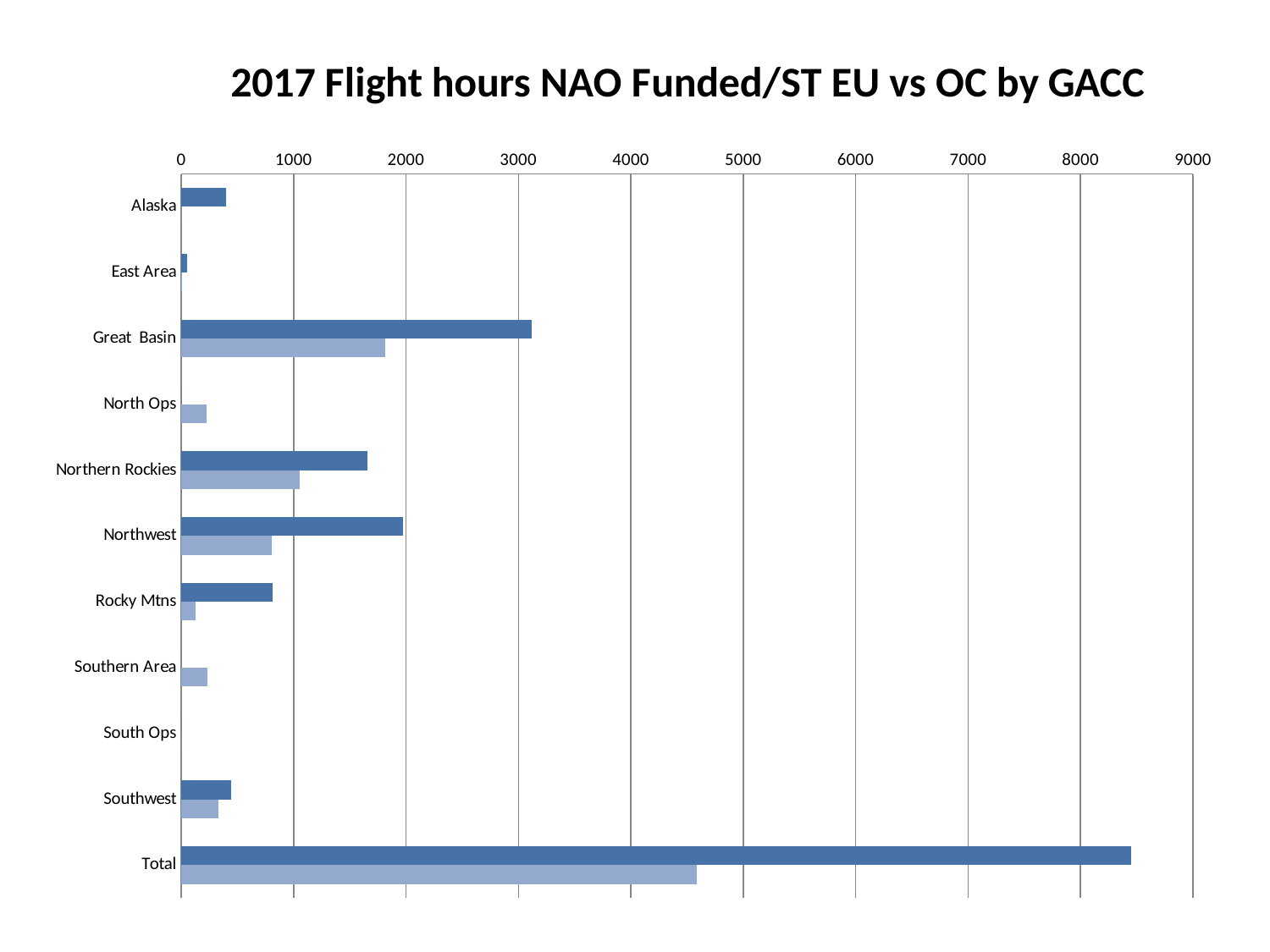
Which has the longer dark blue bar, Great Basin or Northwest? Great Basin Which category shows no visible bar for either series? South Ops Is the dark blue bar for Total greater or less than 8000? greater Is the dark blue bar for Great Basin greater or less than 2000? greater What is the title of the chart? 2017 Flight hours NAO Funded/ST EU vs OC by GACC How many categories are listed on the vertical axis of the chart? 11 What type of chart is shown on the slide? bar chart Which category has the longest dark blue bar? Total Is the light blue bar for Total greater or less than 4000? greater Excluding Total, which GACC has the longest dark blue bar? Great Basin Which has the longer light blue bar, Northern Rockies or Rocky Mtns? Northern Rockies